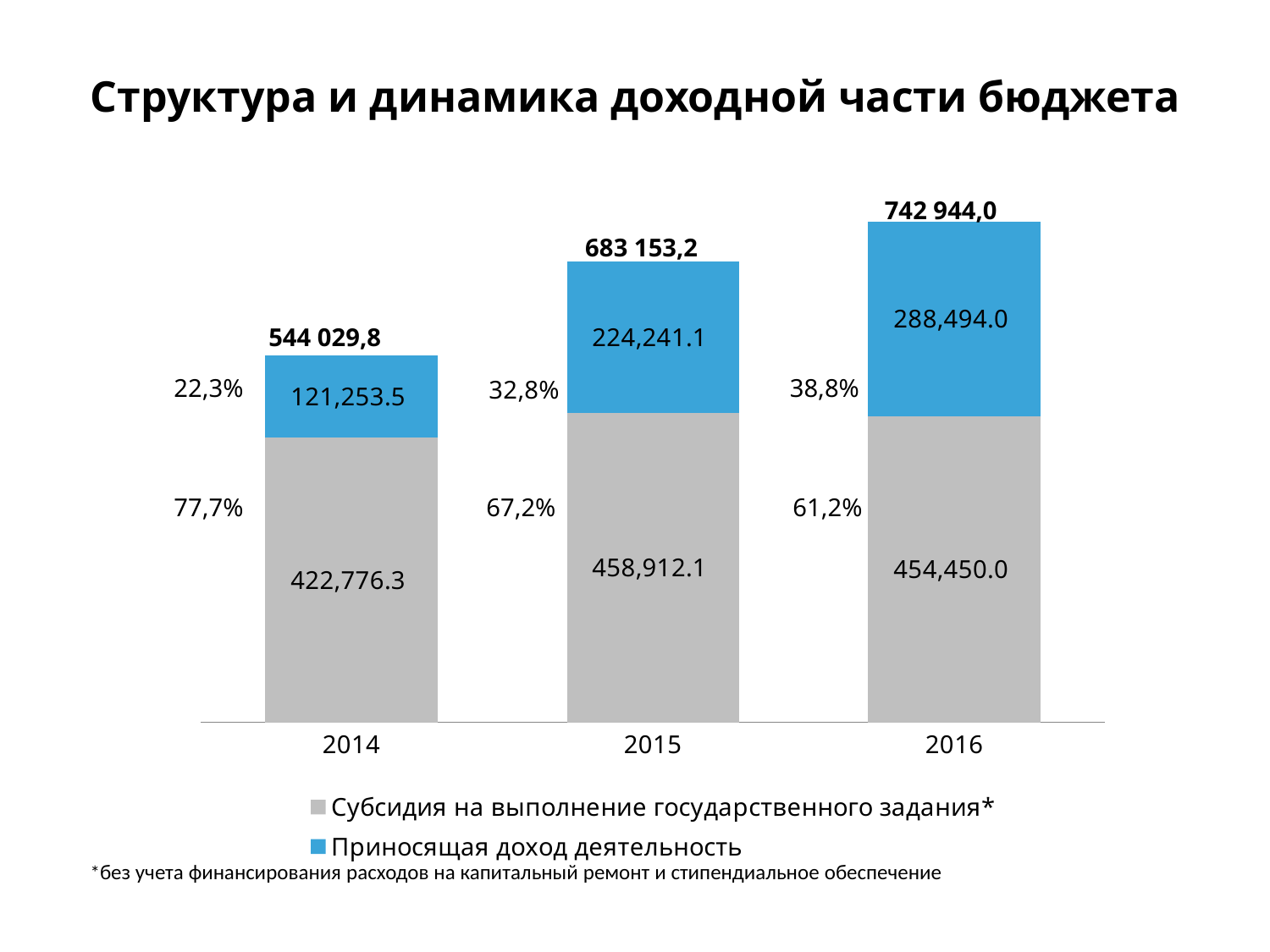
What percentage share does "Субсидия на выполнение государственного задания*" have in 2015? 67,2% What percentage share does "Приносящая доход деятельность" have in 2016? 38,8% Is the value of "Субсидия на выполнение государственного задания*" larger in 2015 or in 2016? 2015 What is the total of the stacked bar for 2016? 742 944,0 How many series does the legend list? 2 What is the value of "Субсидия на выполнение государственного задания*" for 2014? 422,776.3 What type of chart is shown on the slide? stacked bar chart What is the total of the stacked bar for 2014? 544 029,8 Which year has the highest total? 2016 How many years are shown on the x axis? 3 What is the value of "Приносящая доход деятельность" for 2015? 224,241.1 Which year has the lowest value for "Приносящая доход деятельность"? 2014